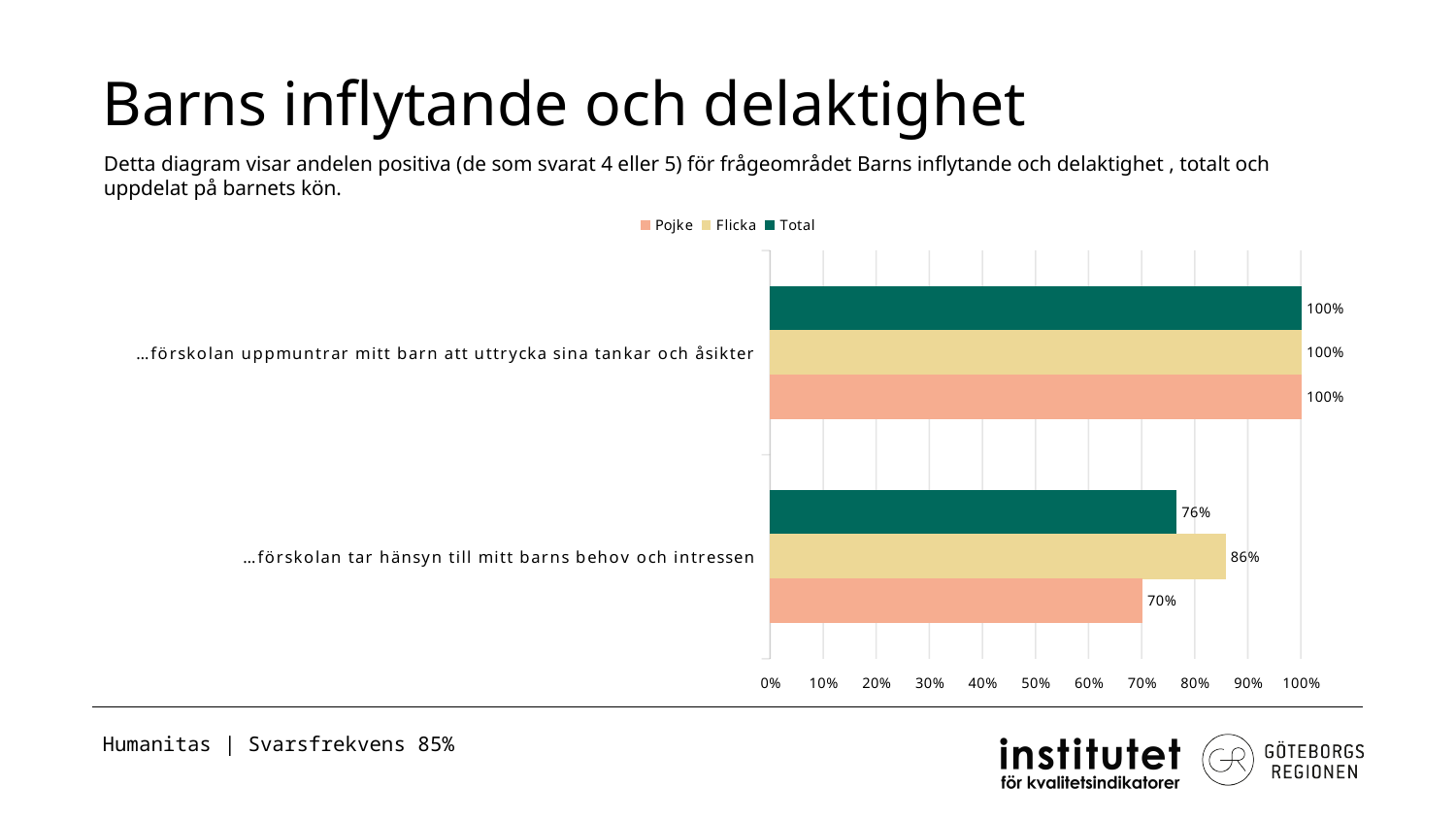
What is the Flicka value for "…förskolan tar hänsyn till mitt barns behov och intressen"? 86% What is the Pojke value for "…förskolan tar hänsyn till mitt barns behov och intressen"? 70% How many series does the legend list? 3 What kind of chart is shown on the slide? bar chart What is the Total value for "…förskolan uppmuntrar mitt barn att uttrycka sina tankar och åsikter"? 100% Which series is shown in dark green in the legend? Total How many categories are plotted on the chart? 2 Which series has the lowest value for "…förskolan tar hänsyn till mitt barns behov och intressen"? Pojke What is the Total value for "…förskolan tar hänsyn till mitt barns behov och intressen"? 76% Which series has the highest value for "…förskolan tar hänsyn till mitt barns behov och intressen"? Flicka What is the difference between the Flicka and Pojke values for "…förskolan tar hänsyn till mitt barns behov och intressen"? 16%